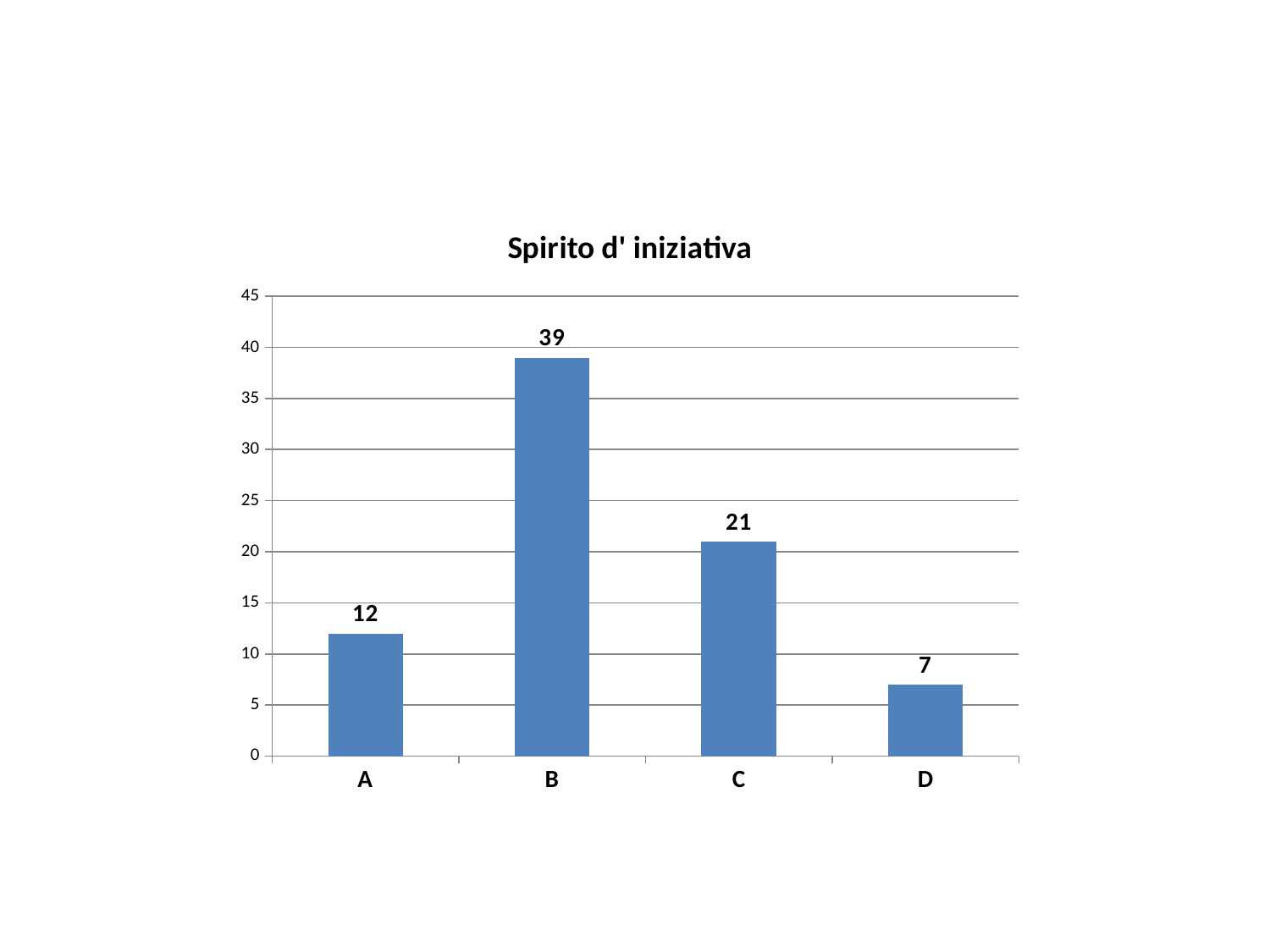
Which category has the lowest value? D What is the difference between the values for A and D? 5 What is the value for category B? 39 What is the value for category A? 12 Is the value for C greater or less than 25? less What is the difference between the values for B and C? 18 What is the title of the chart? Spirito d' iniziativa How many categories are shown on the x axis? 4 What is the value for category D? 7 Which is larger, the value for A or the value for C? C What kind of chart is shown on the slide? bar chart Which category has the highest value? B